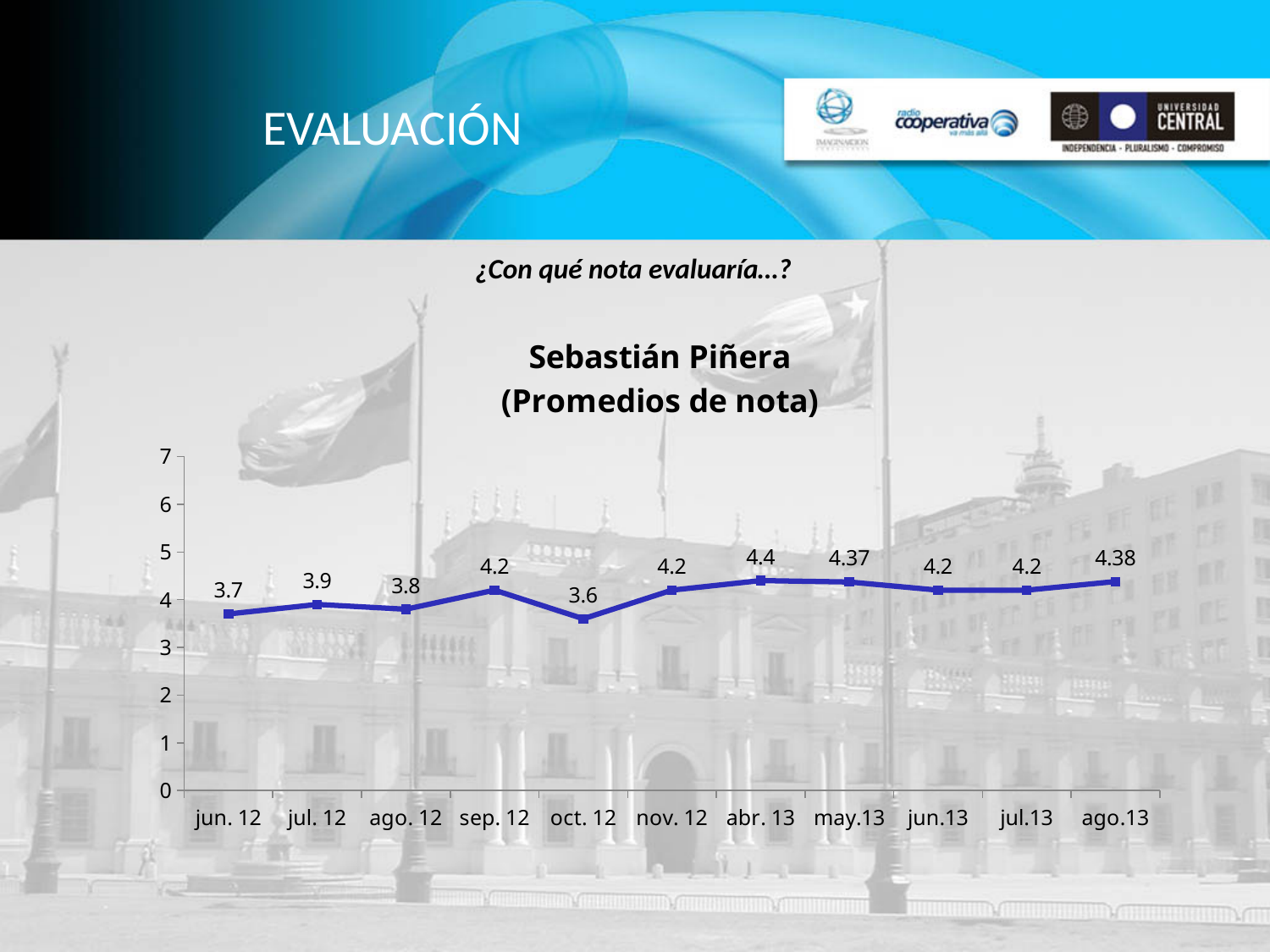
How many data points are plotted on the chart? 11 What is the difference between the values for abr. 13 and oct. 12? 0.8 Does the value rise or fall from sep. 12 to oct. 12? fall What is the value for ago.13? 4.38 What is the value for oct. 12? 3.6 What is the value for may.13? 4.37 What kind of chart is shown on the slide? line chart What is the title of the chart? Sebastián Piñera (Promedios de nota) Which period has the lowest value? oct. 12 Which is larger, the value for jul. 12 or the value for ago. 12? jul. 12 What is the value for jun. 12? 3.7 Which period has the highest value? abr. 13